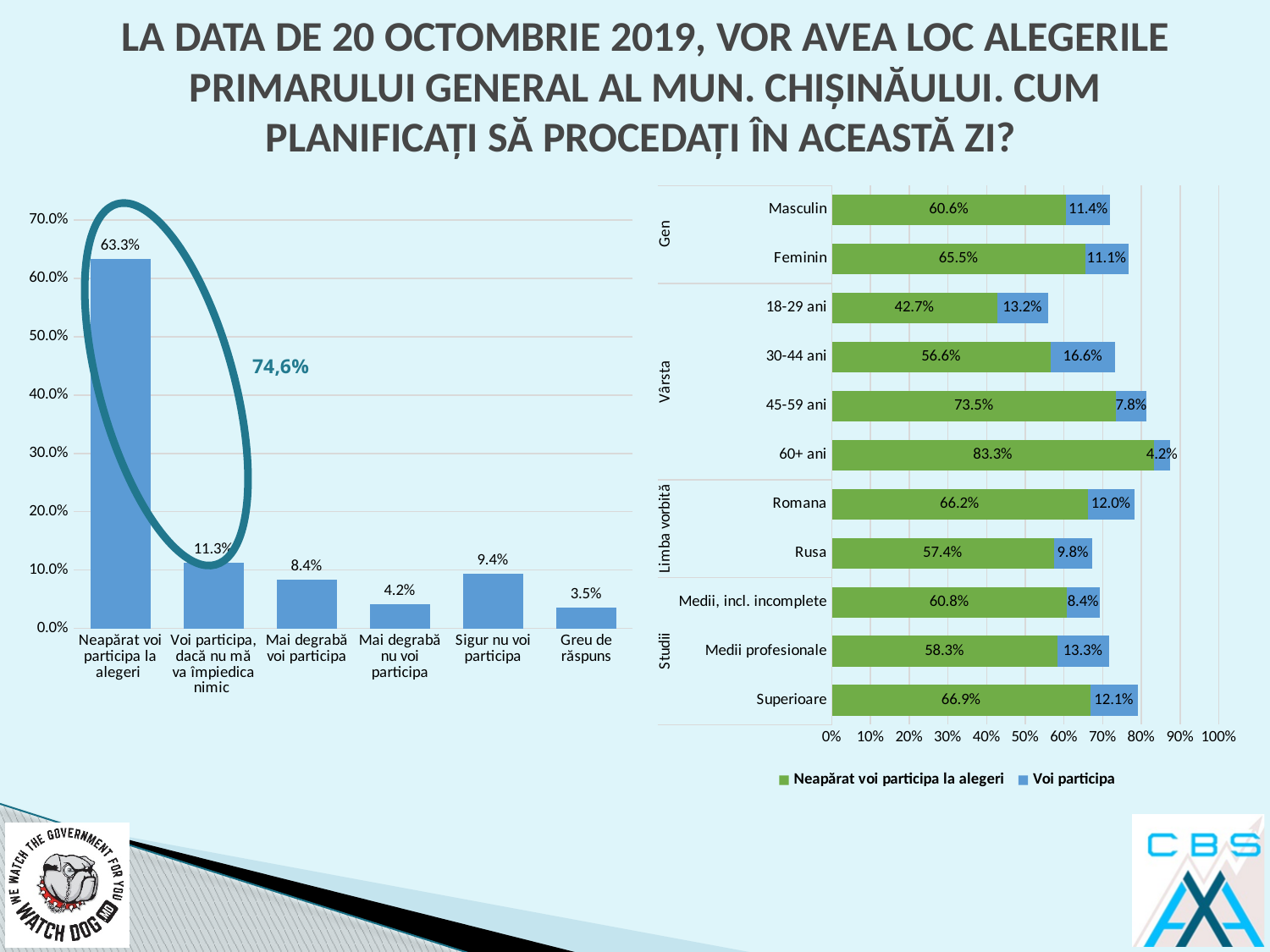
In the left bar chart, what is the difference between "Sigur nu voi participa" and "Mai degrabă nu voi participa"? 5.2% What type of chart is the chart on the left of the slide? Bar chart In the left bar chart, what is the value for "Neapărat voi participa la alegeri"? 63.3% In the right chart, what is the "Voi participa" value for "30-44 ani"? 16.6% In the right chart, what is the total of the stacked bar for "Masculin"? 72.0% In the right chart, which category has the highest "Neapărat voi participa la alegeri" value? 60+ ani In the right chart, what is the "Neapărat voi participa la alegeri" value for "60+ ani"? 83.3% In the left bar chart, which is larger: "Voi participa, dacă nu mă va împiedica nimic" or "Mai degrabă voi participa"? Voi participa, dacă nu mă va împiedica nimic In the left bar chart, which category has the lowest value? Greu de răspuns How many series does the legend of the right chart list? 2 In the left bar chart, how many categories are shown? 6 In the right chart, how many categories are shown on the vertical axis? 11